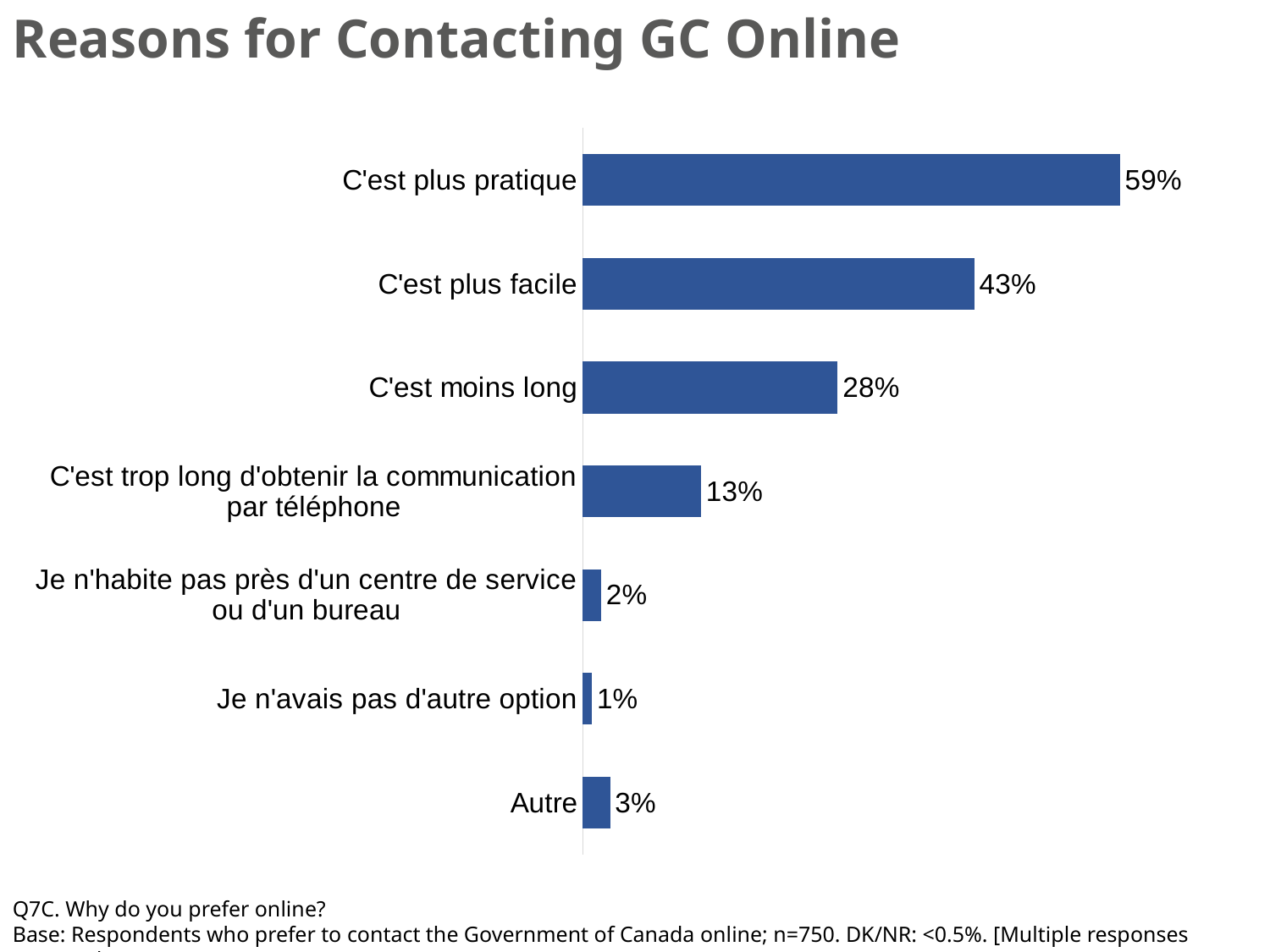
What is the value for "Autre"? 3% What is the value for "C'est trop long d'obtenir la communication par téléphone"? 13% What kind of chart is shown on the slide? Bar chart What is the title of the chart? Reasons for Contacting GC Online What is the difference between the values for "C'est moins long" and "C'est trop long d'obtenir la communication par téléphone"? 15% What is the difference between the values for "C'est plus pratique" and "C'est plus facile"? 16% Which category has the lowest value? Je n'avais pas d'autre option What is the value for "C'est plus pratique"? 59% Which category has the highest value? C'est plus pratique Which is larger: the value for "Autre" or the value for "Je n'habite pas près d'un centre de service ou d'un bureau"? Autre How many categories are shown in the chart? 7 What is the value for "C'est moins long"? 28%